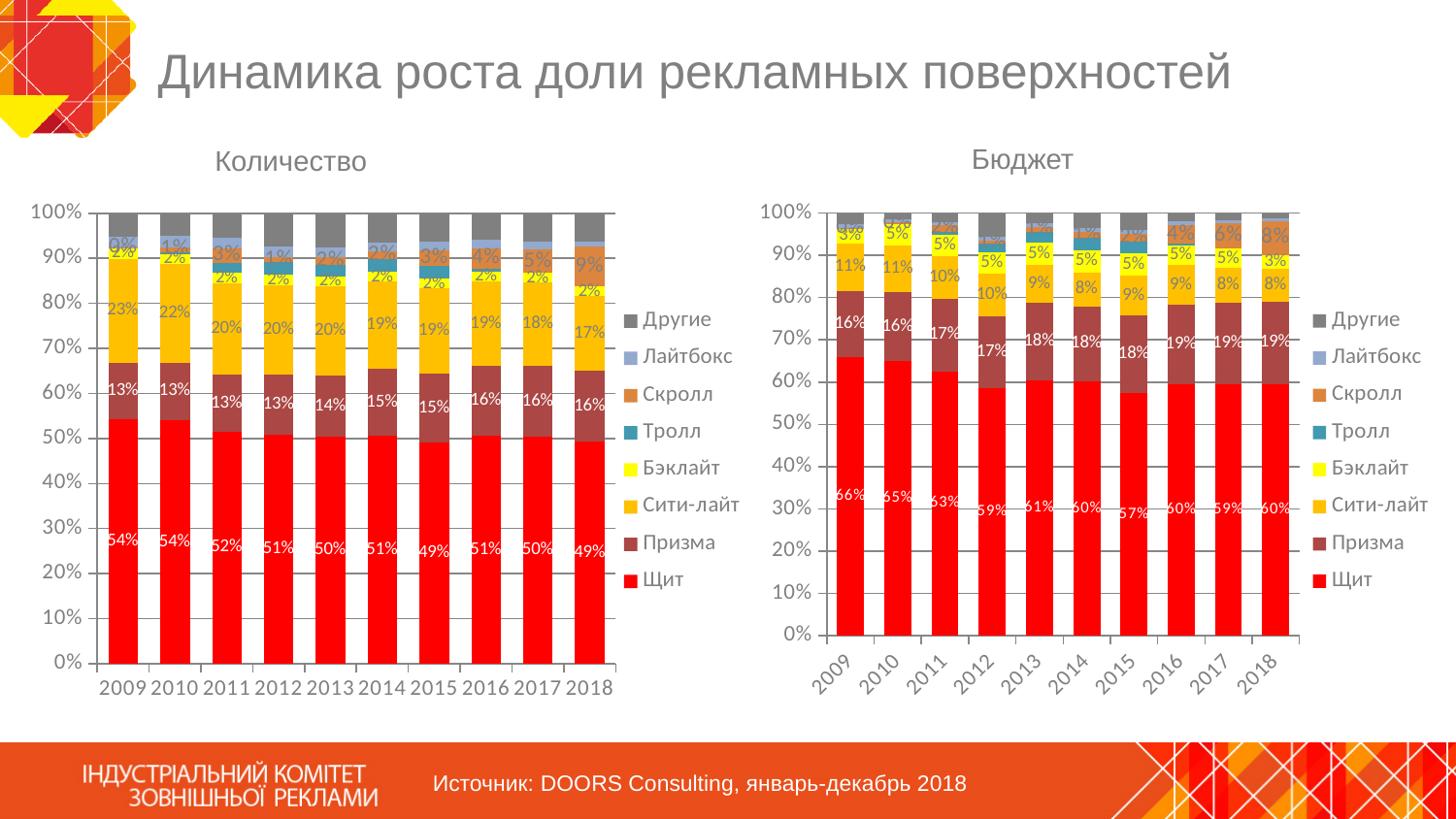
In the "Бюджет" chart, what is the value for Призма in 2018? 19% In the "Бюджет" chart, what is the value for Щит in 2009? 66% In the "Бюджет" chart, which year has the highest value for Щит? 2009 In the "Бюджет" chart, which year has the lowest value for Щит? 2015 In the "Количество" chart, what is the difference between the Сити-лайт value in 2009 and in 2018? 6% In the "Бюджет" chart, is the Щит value in 2009 larger or smaller than in 2018? larger How many years are shown on the x axis of the "Количество" chart? 10 In the "Количество" chart, what is the value for Щит in 2009? 54% How many series does the legend of the "Бюджет" chart list? 8 What type of chart is the "Количество" chart? stacked bar chart In the "Количество" chart, does the Призма share rise or fall from 2009 to 2018? rise In the "Количество" chart, what is the value for Сити-лайт in 2018? 17%